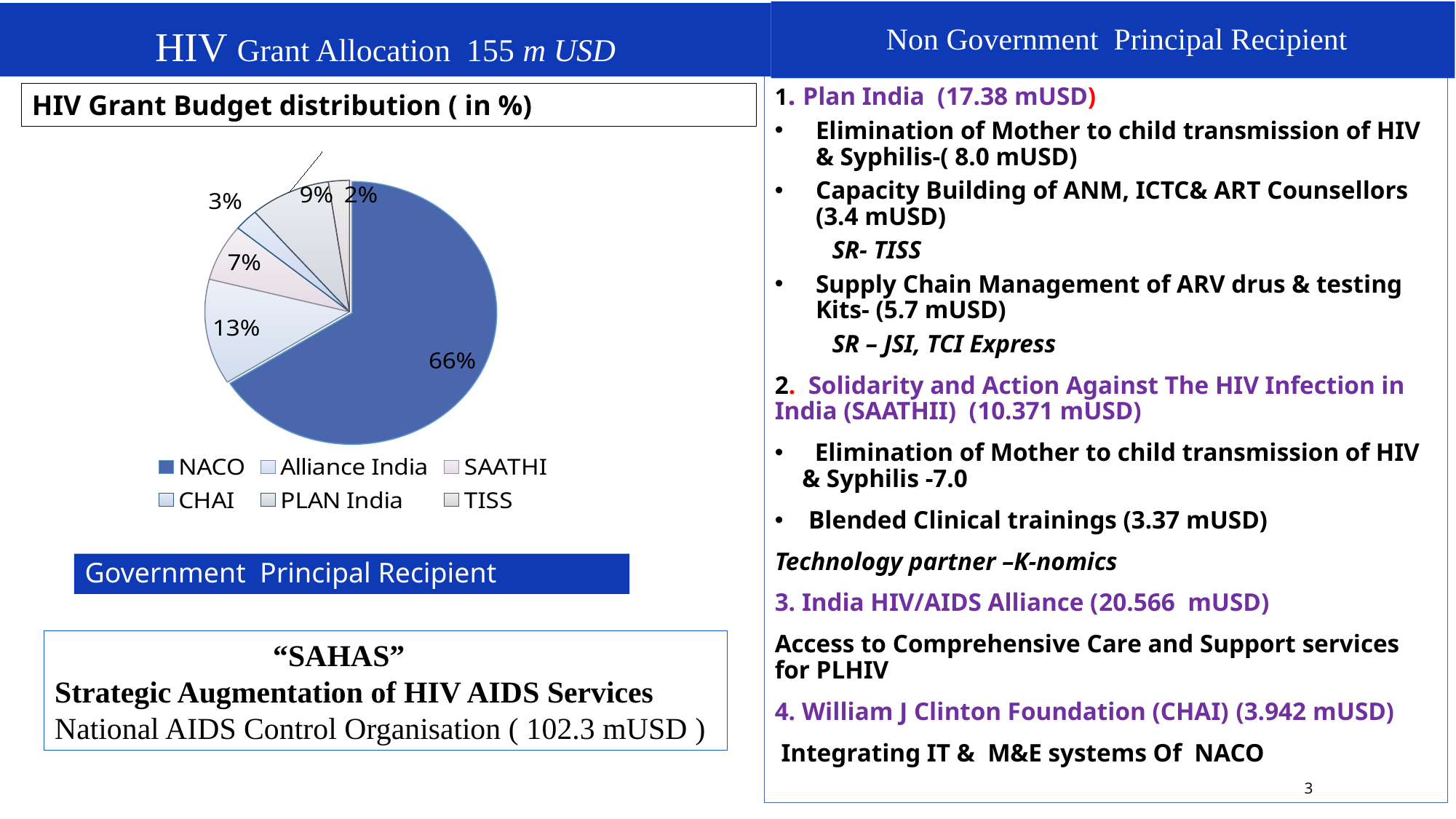
What share of the HIV grant budget goes to NACO? 66% What share of the HIV grant budget goes to PLAN India? 9% What share of the HIV grant budget goes to SAATHI? 7% Which category has the smallest slice of the pie chart? TISS What is the title of the chart? HIV Grant Budget distribution ( in %) Which category has the largest slice of the pie chart? NACO What kind of chart is shown on the slide? pie chart How many categories does the legend of the pie chart list? 6 What is the difference in percentage points between the NACO share and the Alliance India share? 53 Which has a larger share of the budget, CHAI or PLAN India? PLAN India